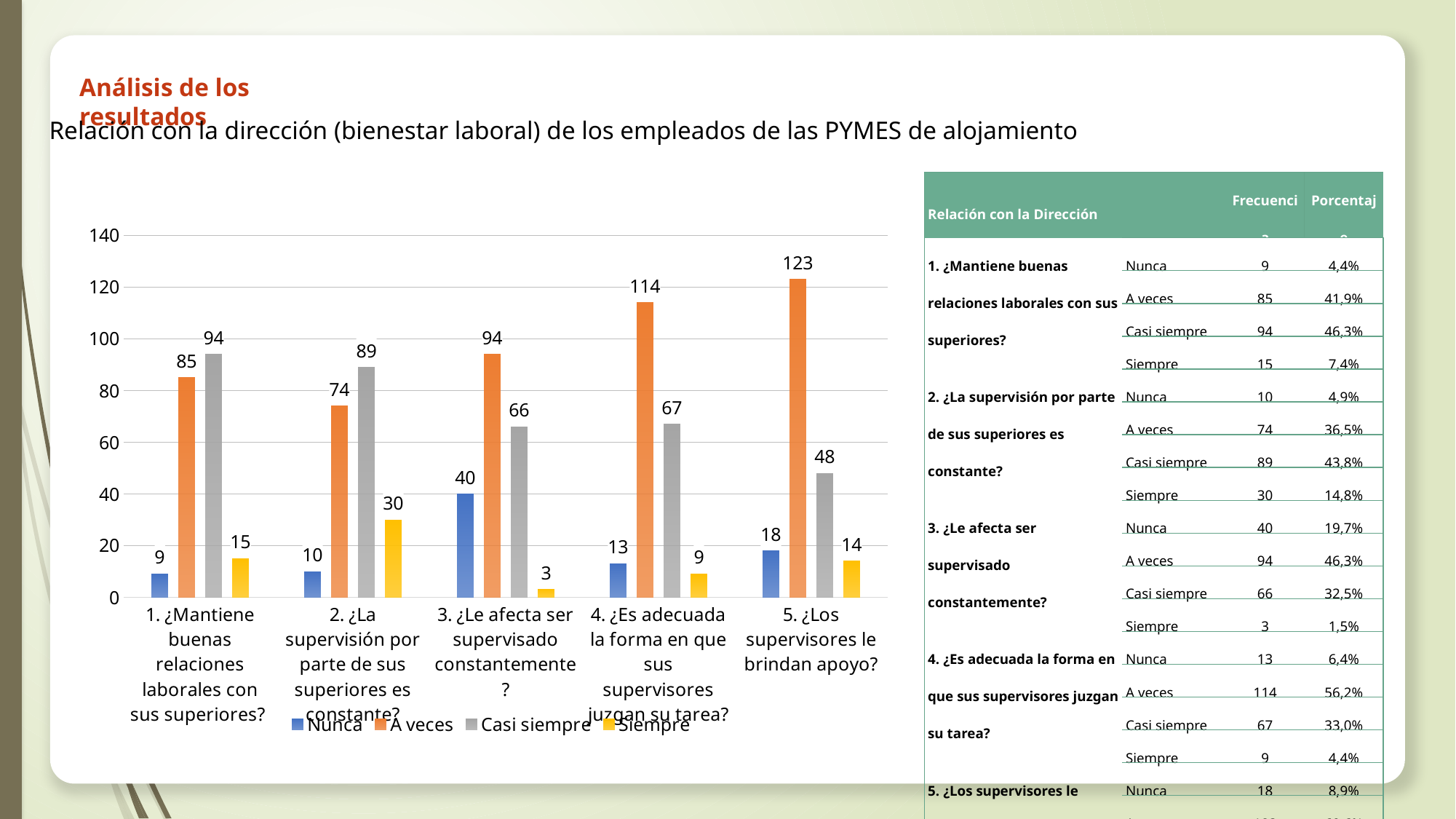
Is the "Casi siempre" value for question 5 (¿Los supervisores le brindan apoyo?) greater or less than 60? less Which series is shown in orange in the chart legend? A veces Which category has the lowest "Siempre" value? 3. ¿Le afecta ser supervisado constantemente? What is the difference between the "A veces" and "Casi siempre" values for question 4 (¿Es adecuada la forma en que sus supervisores juzgan su tarea?)? 47 For question 1 (¿Mantiene buenas relaciones laborales con sus superiores?), which is larger: "A veces" or "Casi siempre"? Casi siempre Which category has the highest "A veces" value? 5. ¿Los supervisores le brindan apoyo? What is the value of the "A veces" bar for question 5 (¿Los supervisores le brindan apoyo?)? 123 What is the value of the "Siempre" bar for question 2 (¿La supervisión por parte de sus superiores es constante?)? 30 What type of chart is shown on the slide? Bar chart What is the value of the "Nunca" bar for question 3 (¿Le afecta ser supervisado constantemente?)? 40 How many categories (questions) are shown on the x axis of the chart? 5 How many series does the chart legend list? 4